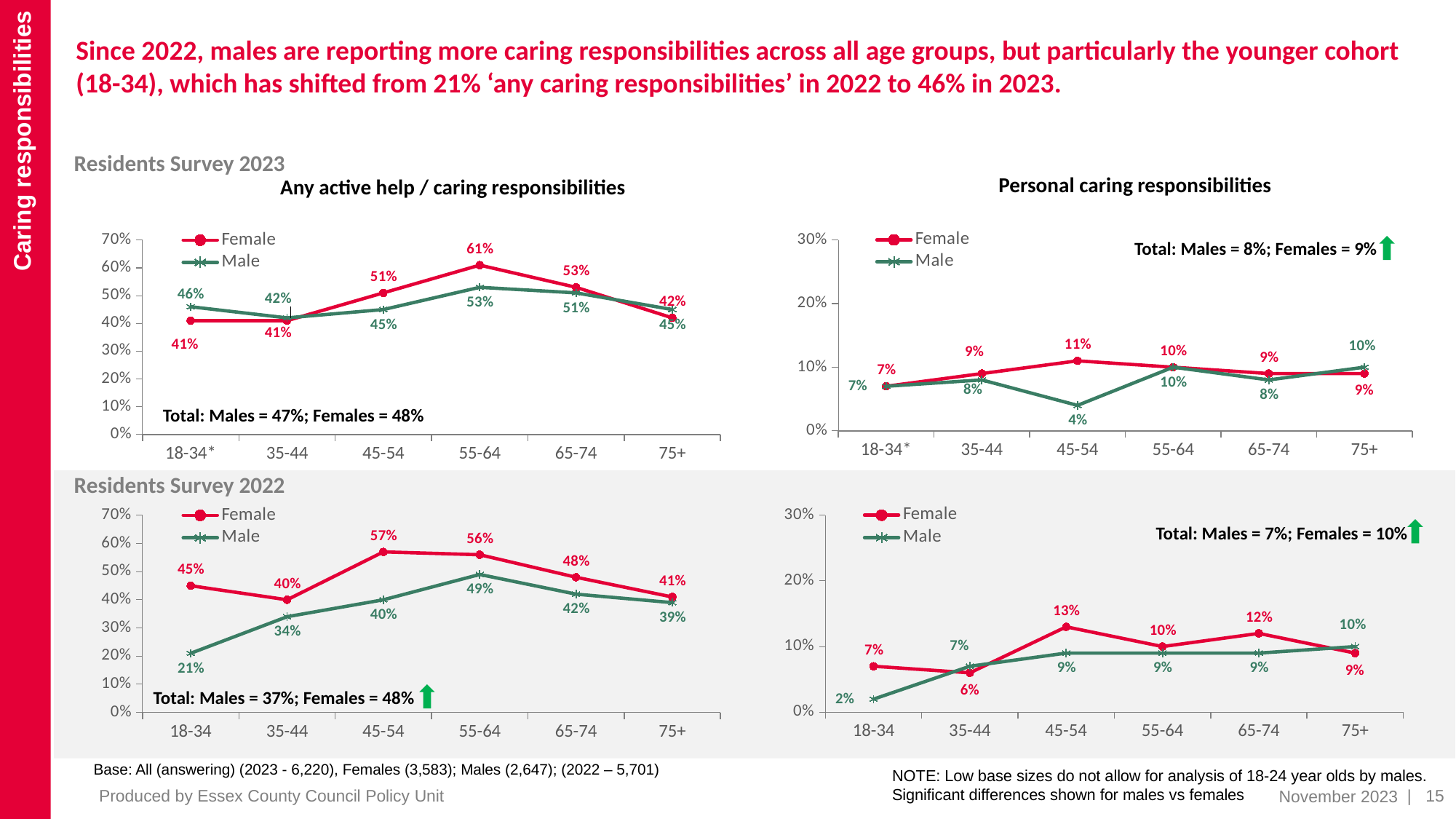
What type of chart is the 2023 'Personal caring responsibilities' chart (top right)? Line chart In the 2022 'Any active help / caring responsibilities' chart (bottom left), which age group has the highest Female value? 45-54 In the 2023 'Any active help / caring responsibilities' chart (top left), what is the Female value for the 55-64 age group? 61% In the 2022 'Personal caring responsibilities' chart (bottom right), which is larger for the 35-44 age group, the Female value or the Male value? Male In the 2023 'Personal caring responsibilities' chart (top right), which age group has the lowest Male value? 45-54 How many age groups are shown on the x axis of the 2023 'Any active help / caring responsibilities' chart (top left)? 6 In the 2023 'Any active help / caring responsibilities' chart (top left), what is the Male value for the 18-34* age group? 46% In the 2022 'Any active help / caring responsibilities' chart (bottom left), what total is given for Males? 37% In the 2022 'Any active help / caring responsibilities' chart (bottom left), what is the Male value for the 18-34 age group? 21% In the 2023 'Personal caring responsibilities' chart (top right), what is the difference between the Female and Male values for the 45-54 age group? 7% In the 2022 'Personal caring responsibilities' chart (bottom right), what is the Female value for the 45-54 age group? 13% How many series does the legend list in the 2022 'Personal caring responsibilities' chart (bottom right)? 2